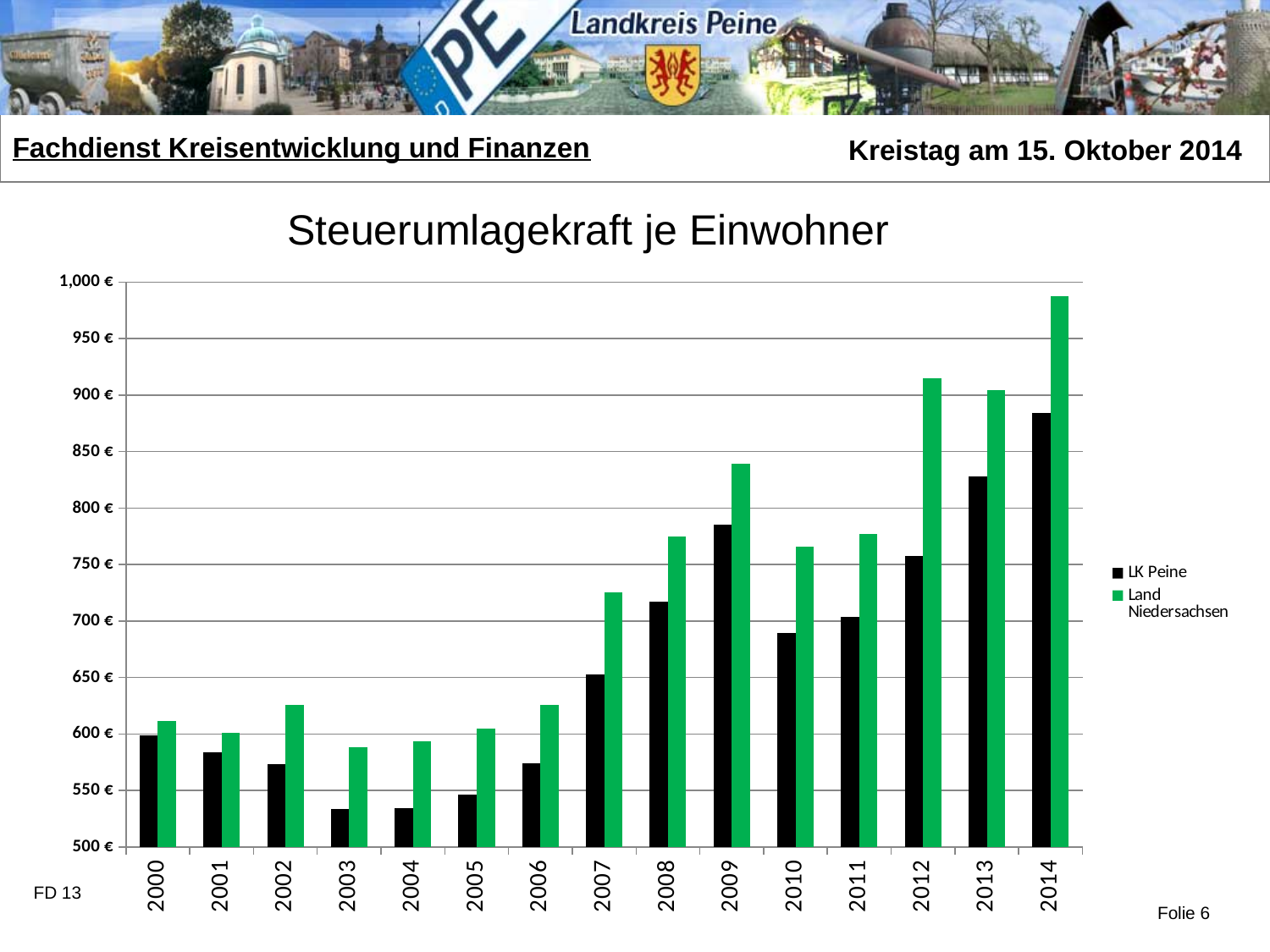
Is the value for LK Peine in 2010 greater or less than 700 €? less In which year is the value for Land Niedersachsen highest? 2014 What is the title of the chart? Steuerumlagekraft je Einwohner What kind of chart is shown on the slide? bar chart How many years are shown on the x axis? 15 In 2012, which is larger: LK Peine or Land Niedersachsen? Land Niedersachsen How many series does the legend list? 2 Is the value for LK Peine in 2009 greater or less than 750 €? greater Which colour represents Land Niedersachsen in the chart? green Do the values for LK Peine rise or fall from 2011 to 2014? rise Is the value for Land Niedersachsen in 2014 greater or less than 950 €? greater In which year is the value for LK Peine highest? 2014